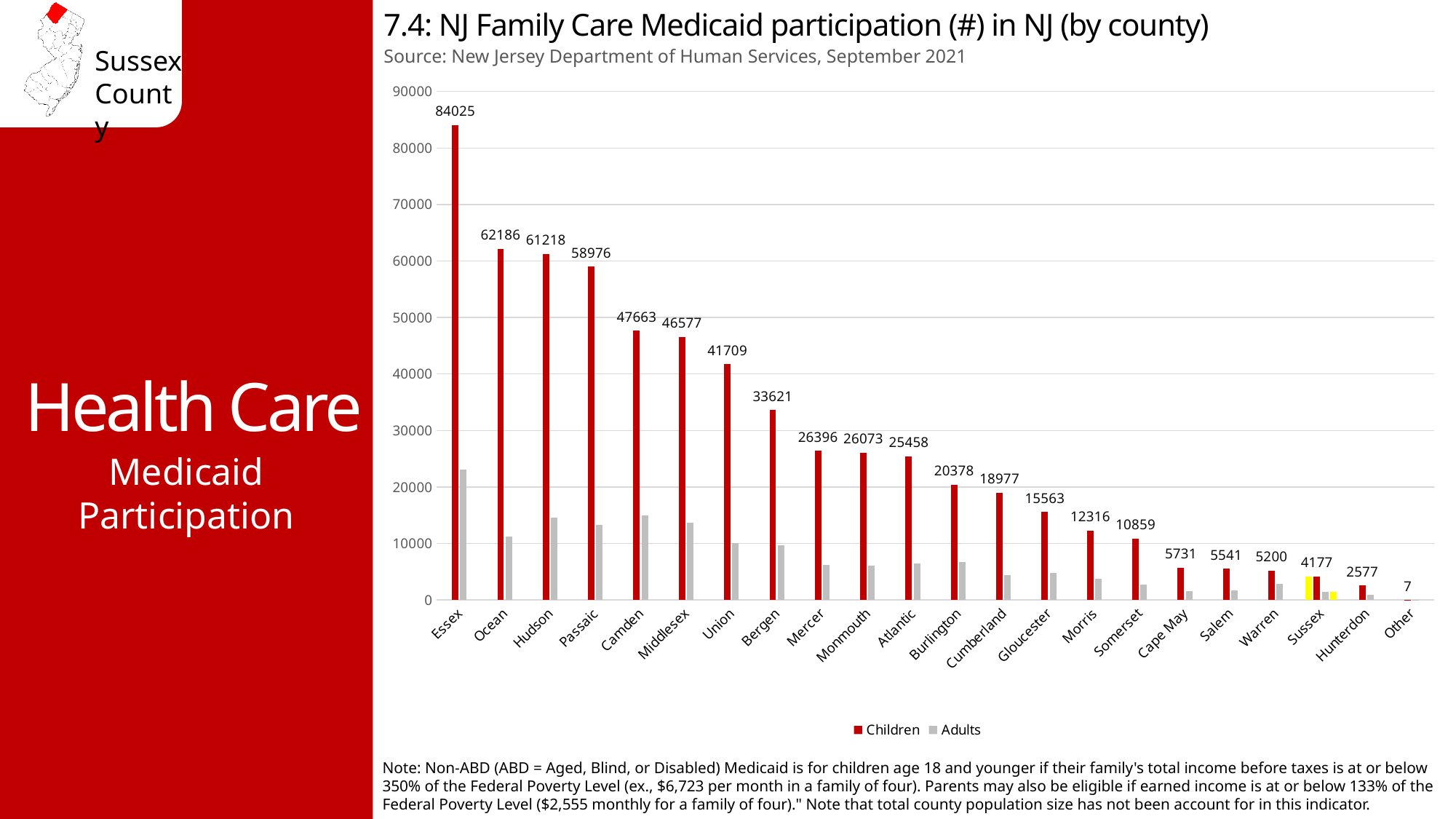
Do the Children values rise or fall from left to right along the x axis? fall How many series does the legend list? 2 Which has a larger Children value, Camden or Union? Camden How many categories are shown on the x axis? 22 Which category has the lowest Children value? Other What is the Children value for Essex? 84025 Is the Adults value for Essex greater or less than 20000? greater What is the Children value for Sussex? 4177 Which county has the highest Children value? Essex Is the Adults value for Sussex greater or less than 10000? less What kind of chart is shown? bar chart What is the difference between the Children values for Ocean and Hudson? 968